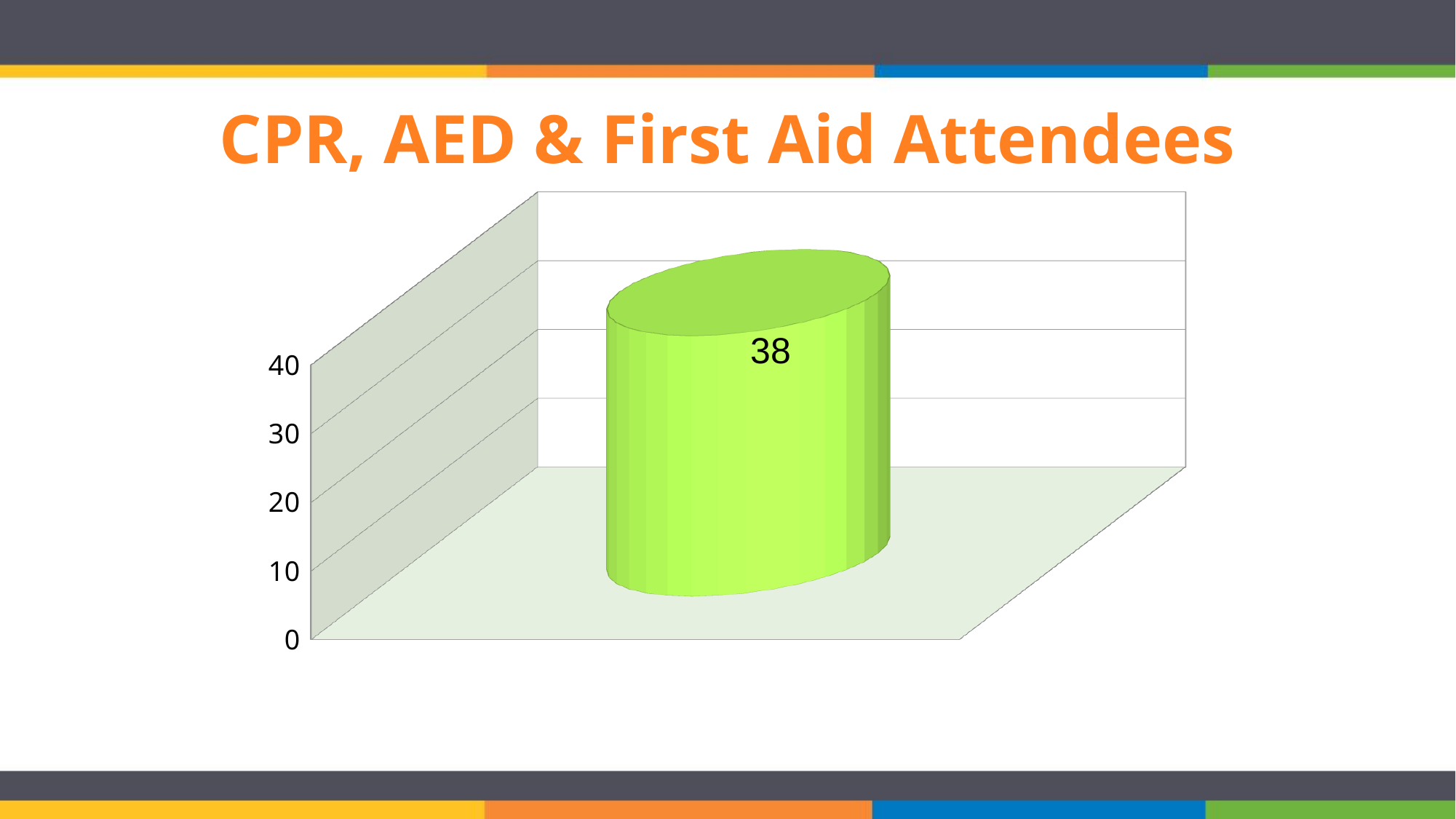
What value is shown on the single bar in the chart? 38 Is the value of the bar greater or less than 40? less What is the highest tick value shown on the vertical axis? 40 Is the value of the bar greater or less than 30? greater How many bars are plotted in the chart? 1 What is the title of the slide containing the chart? CPR, AED & First Aid Attendees What kind of chart is shown on the slide? bar chart